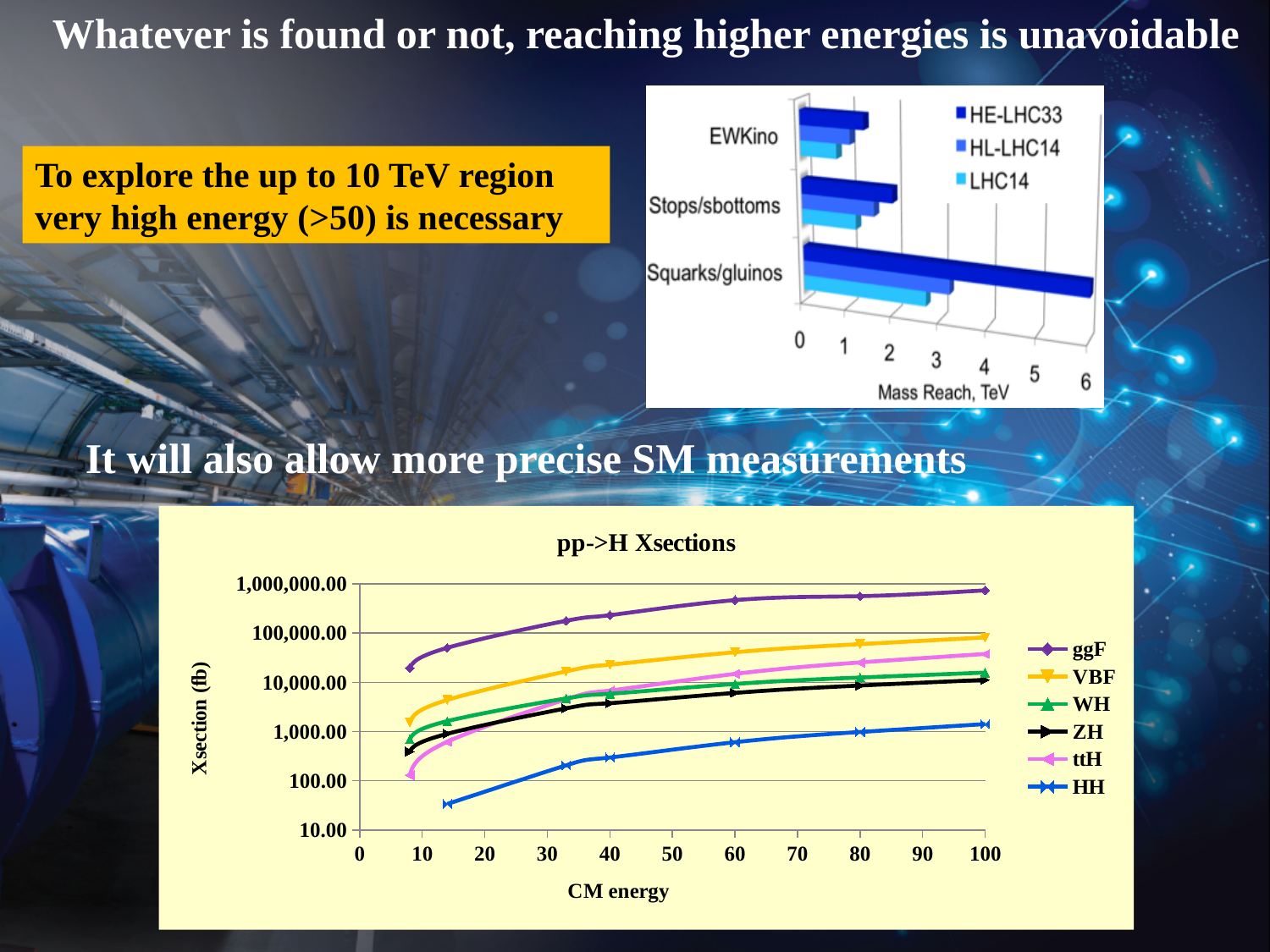
In the Mass Reach chart at the top right, which category has the shortest bars? EWKino In the Mass Reach chart at the top right, which category has the longest bar? Squarks/gluinos In the pp->H Xsections chart, do the cross sections rise or fall as CM energy increases? rise In the pp->H Xsections chart, is the ggF value at 100 CM energy greater or less than 1,000,000.00? less In the pp->H Xsections chart, which series has the highest cross section across the whole CM energy range? ggF In the pp->H Xsections chart, how many series does the legend list? 6 In the Mass Reach chart at the top right, is the LHC14 value for Squarks/gluinos greater or less than 2 TeV? greater What kind of chart is the Mass Reach chart at the top right? bar chart In the Mass Reach chart at the top right, how many categories are shown? 3 In the Mass Reach chart at the top right, how many series does the legend list? 3 In the pp->H Xsections chart, which series has the lowest cross section? HH In the Mass Reach chart at the top right, is the HE-LHC33 value for Squarks/gluinos greater or less than 5 TeV? greater